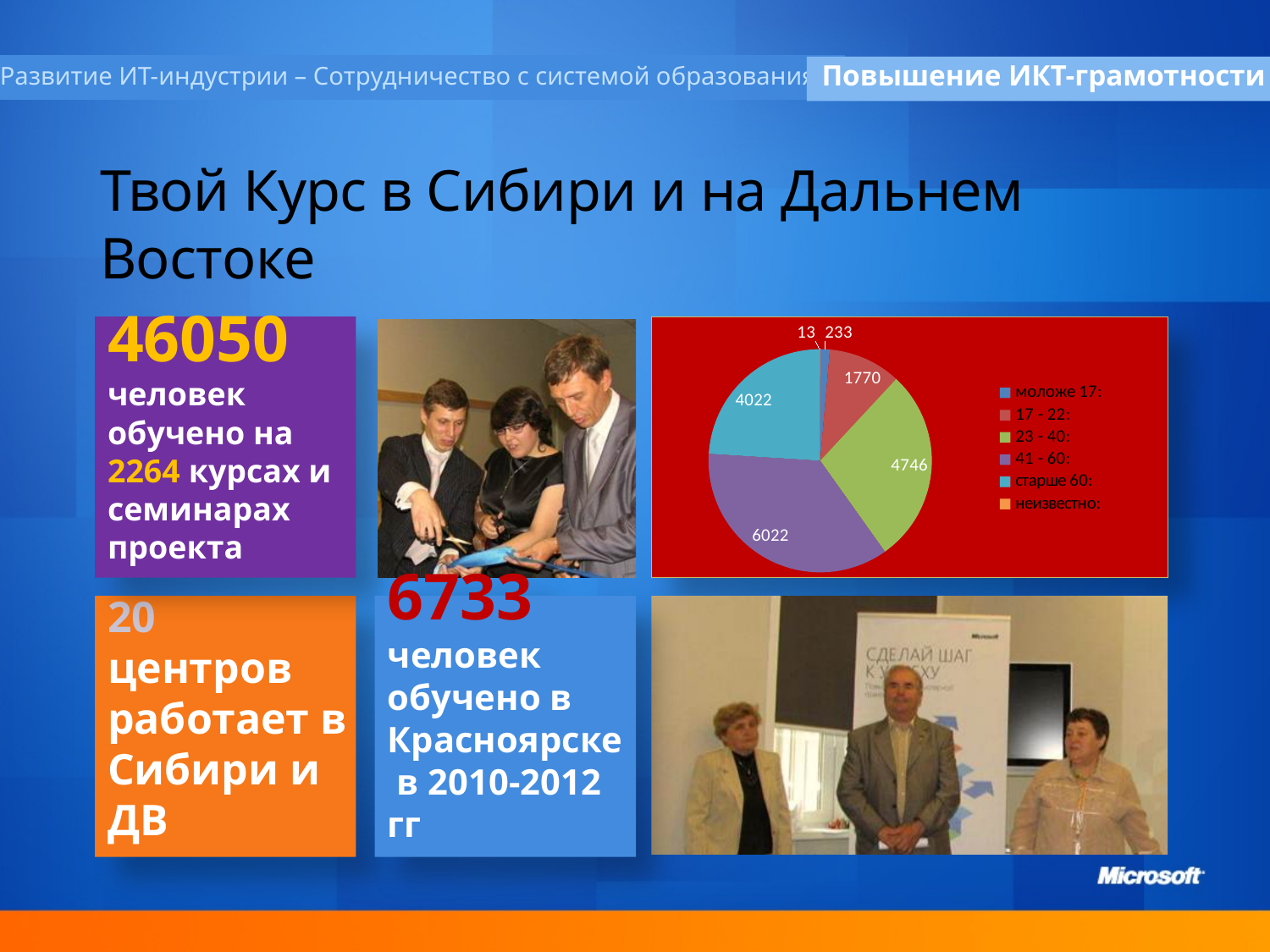
What is the difference between the 41 - 60 slice and the 23 - 40 slice? 1276 What is the last entry listed in the pie chart legend? неизвестно: Which slice is larger: 23 - 40 or старше 60? 23 - 40 Which age group has the largest slice in the pie chart? 41 - 60 In the pie chart, what is the value for the 17 - 22 age group? 1770 In the pie chart, what is the value for the 41 - 60 age group? 6022 How many slices does the pie chart have? 6 What kind of chart is shown on the slide? pie chart What is the smallest value printed on the pie chart? 13 In the pie chart, what is the value for the 23 - 40 age group? 4746 In the pie chart, what is the value for the старше 60 group? 4022 How many entries does the pie chart legend list? 6